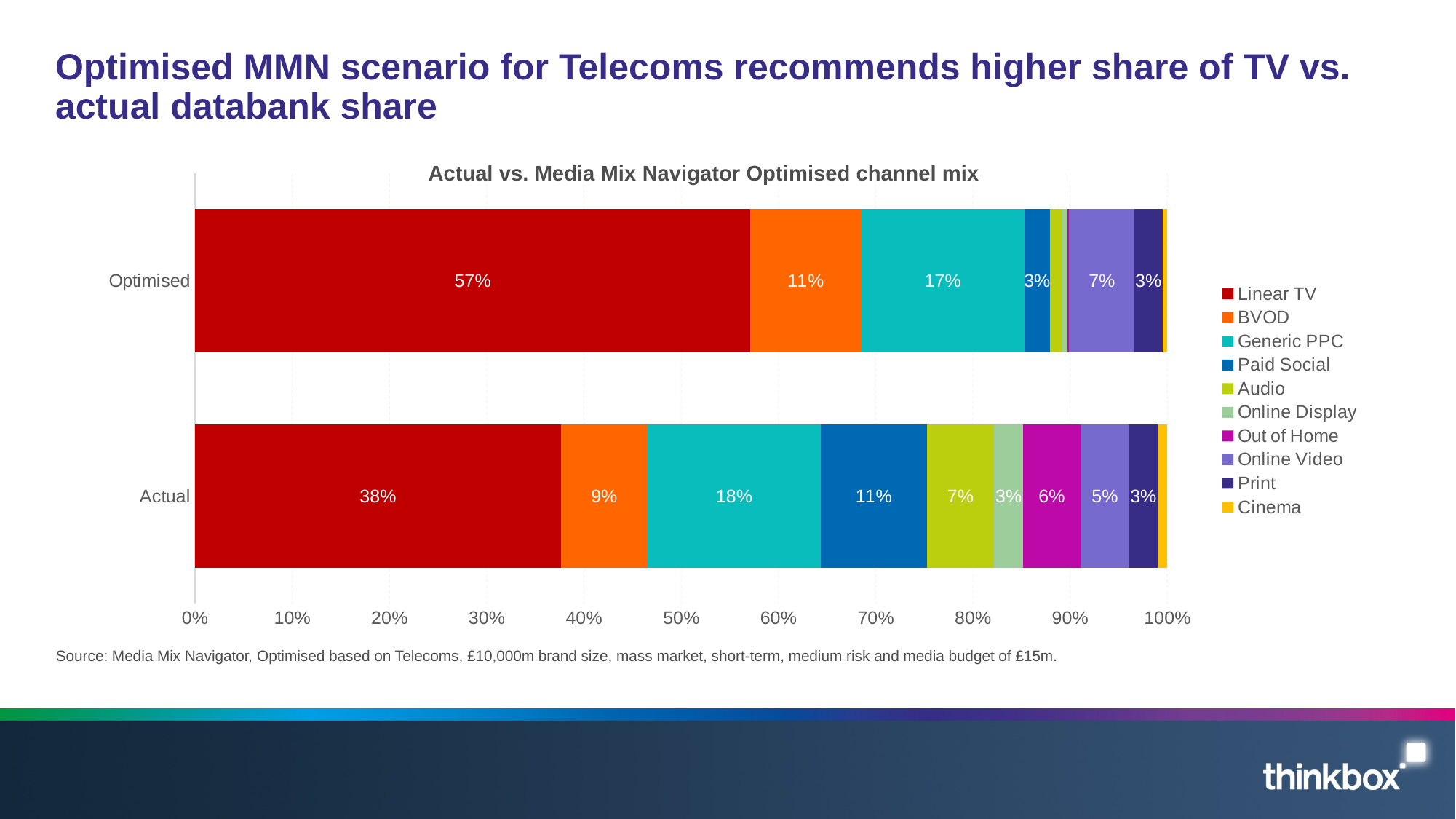
How many series does the legend list? 10 By how many percentage points is the Linear TV share higher in the Optimised scenario than in the Actual mix? 19 percentage points What is the title of the chart? Actual vs. Media Mix Navigator Optimised channel mix What is the Paid Social share in the Actual channel mix? 11% Which channel has the largest share in the Actual channel mix? Linear TV What is the Out of Home share in the Actual channel mix? 6% Which has the larger Paid Social share, Optimised or Actual? Actual What is the Generic PPC share in the Actual channel mix? 18% What is the Linear TV share in the Actual channel mix? 38% What is the Online Video share in the Optimised scenario? 7% What is the Linear TV share in the Optimised scenario? 57% What type of chart is shown on the slide? Stacked bar chart